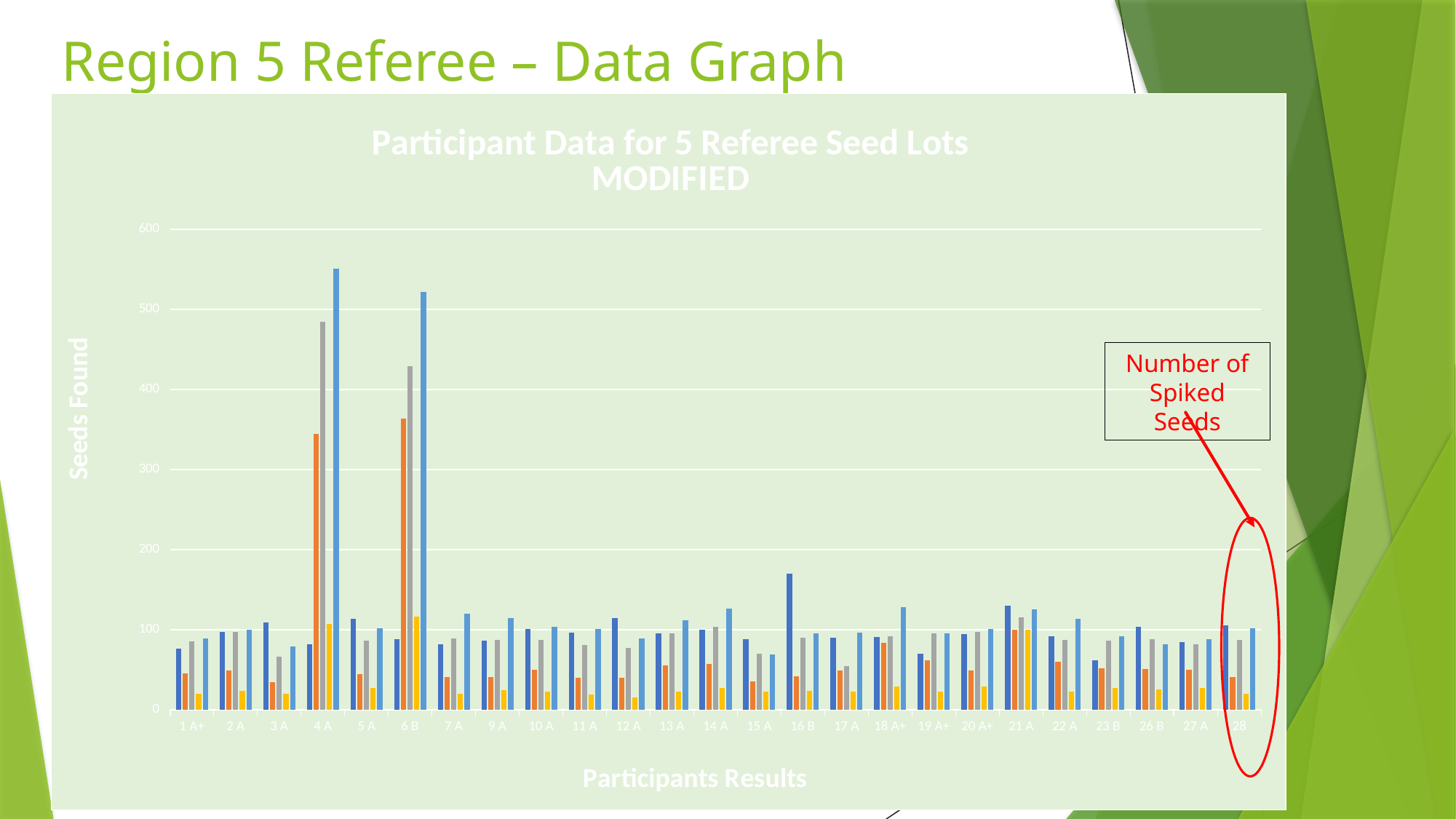
How many participant categories are shown along the x axis? 25 Is the orange bar for participant 4 A greater or less than 300? greater What is the title of the chart? Participant Data for 5 Referee Seed Lots MODIFIED Which participant category contains the tallest bar in the chart? 4 A Which is taller: the tallest bar for participant 4 A or the tallest bar for participant 6 B? 4 A Is the dark blue bar for participant 16 B greater or less than 200? less What kind of chart is shown on the slide? bar chart Which is taller: the gray bar for participant 4 A or the gray bar for participant 6 B? 4 A What is the label on the vertical axis of the chart? Seeds Found Is the tallest bar for participant 6 B greater or less than 500? greater